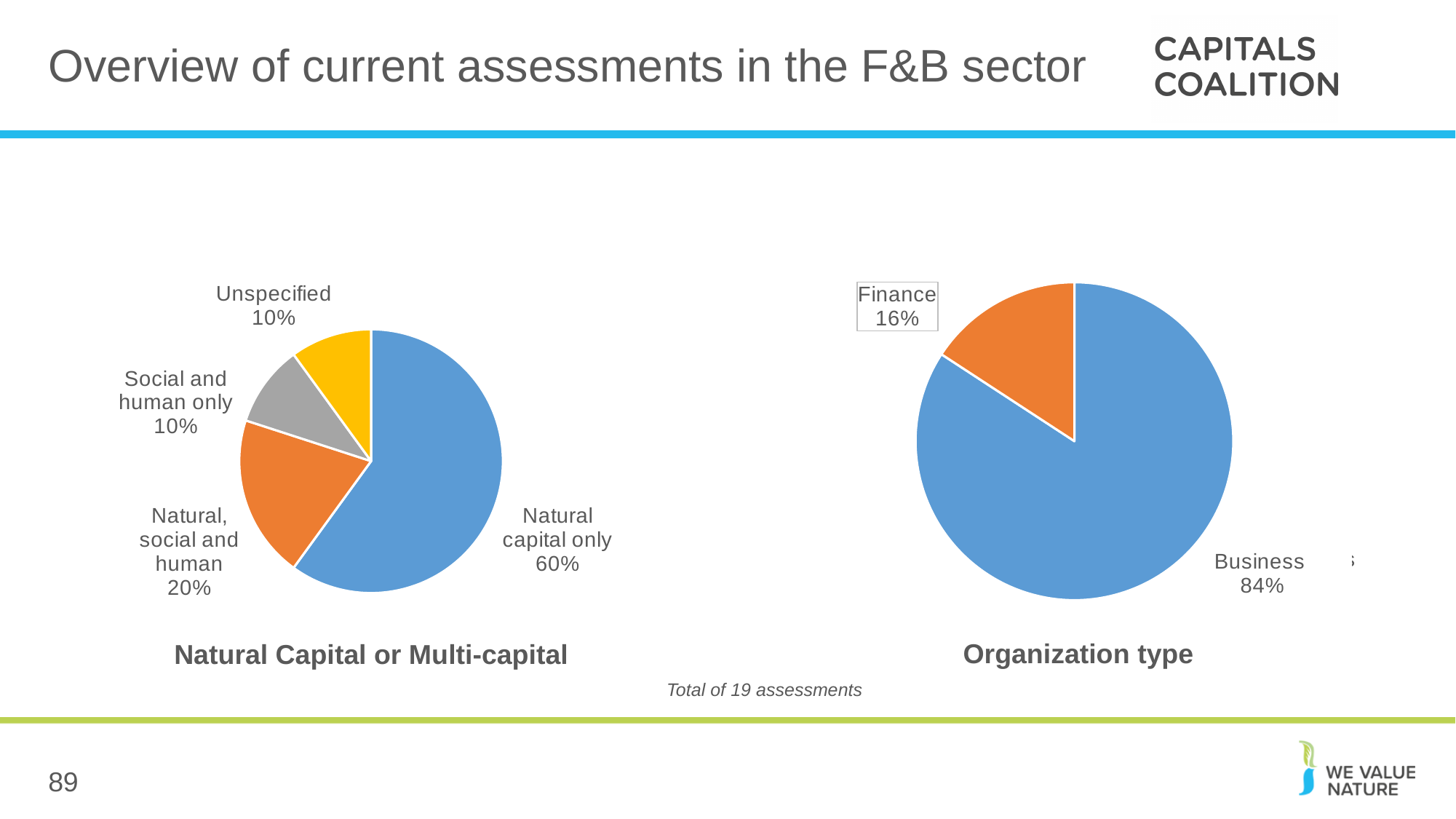
In the 'Organization type' chart, which category has the smallest share? Finance What type of chart is the 'Organization type' chart? Pie chart In the 'Natural Capital or Multi-capital' chart, what share does 'Social and human only' have? 10% In the 'Natural Capital or Multi-capital' chart, how many slices does the pie have? 4 In the 'Organization type' chart, what share does 'Finance' have? 16% According to the note below the charts, how many assessments are included in total? 19 In the 'Natural Capital or Multi-capital' chart, which category has the largest share? Natural capital only In the 'Organization type' chart, what share does 'Business' have? 84% In the 'Natural Capital or Multi-capital' chart, what share does 'Natural, social and human' have? 20% In the 'Natural Capital or Multi-capital' chart, what is the difference in percentage points between 'Natural capital only' and 'Natural, social and human'? 40 percentage points In the 'Natural Capital or Multi-capital' chart, which is larger: 'Natural, social and human' or 'Unspecified'? Natural, social and human In the 'Natural Capital or Multi-capital' chart, what share does 'Natural capital only' have? 60%